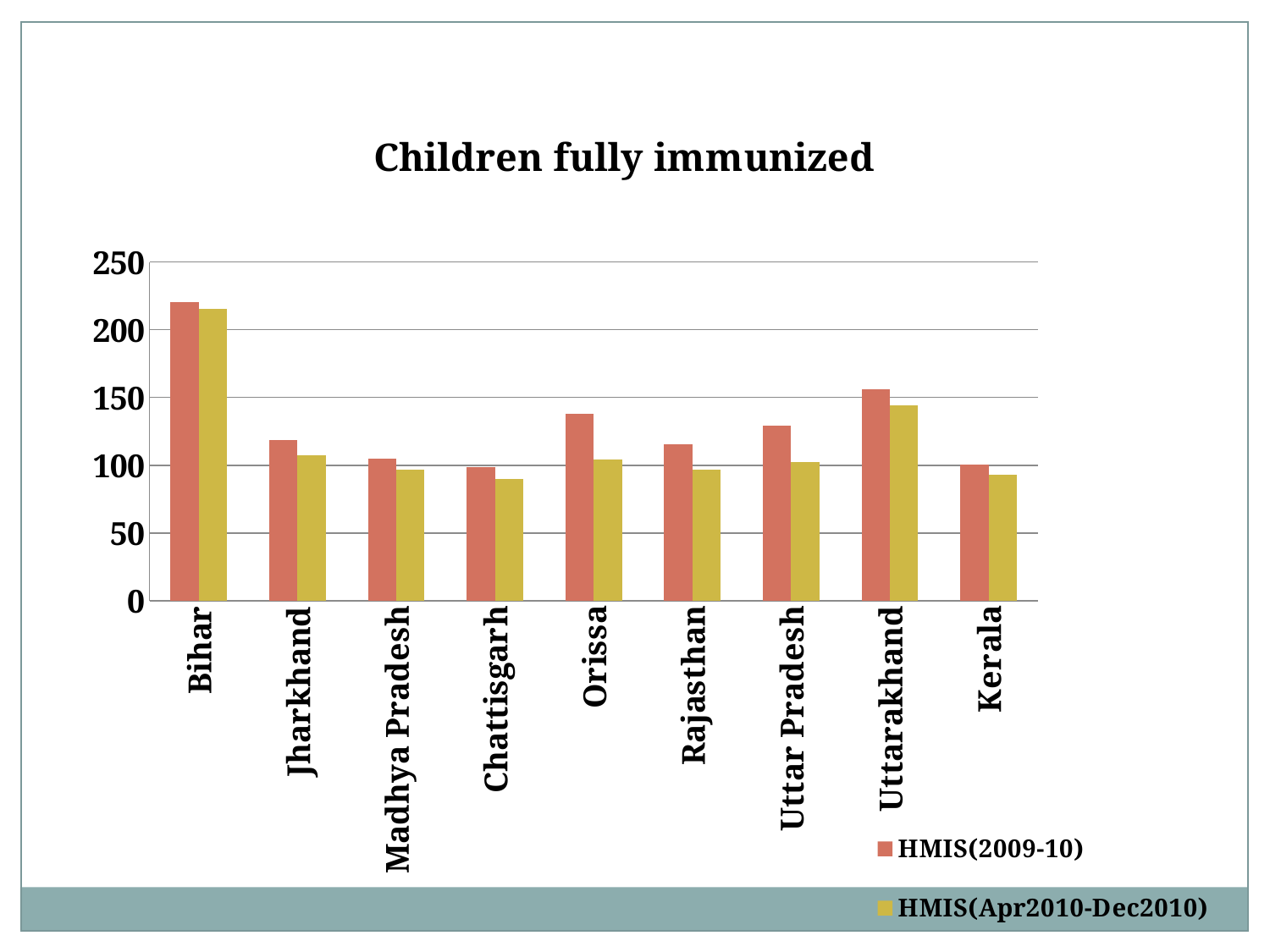
Which state has the highest value for HMIS(Apr2010-Dec2010)? Bihar Is the HMIS(2009-10) value for Orissa greater or less than 150? less What is the title of the chart? Children fully immunized Is the HMIS(2009-10) value for Bihar greater or less than 200? greater Is the HMIS(Apr2010-Dec2010) value for Chattisgarh greater or less than 100? less For HMIS(2009-10), which is larger: Orissa or Rajasthan? Orissa What kind of chart is shown on the slide? bar chart How many series does the legend list? 2 How many states are shown on the x axis? 9 Which state has the highest value for HMIS(2009-10)? Bihar For HMIS(2009-10), which is larger: Uttarakhand or Uttar Pradesh? Uttarakhand